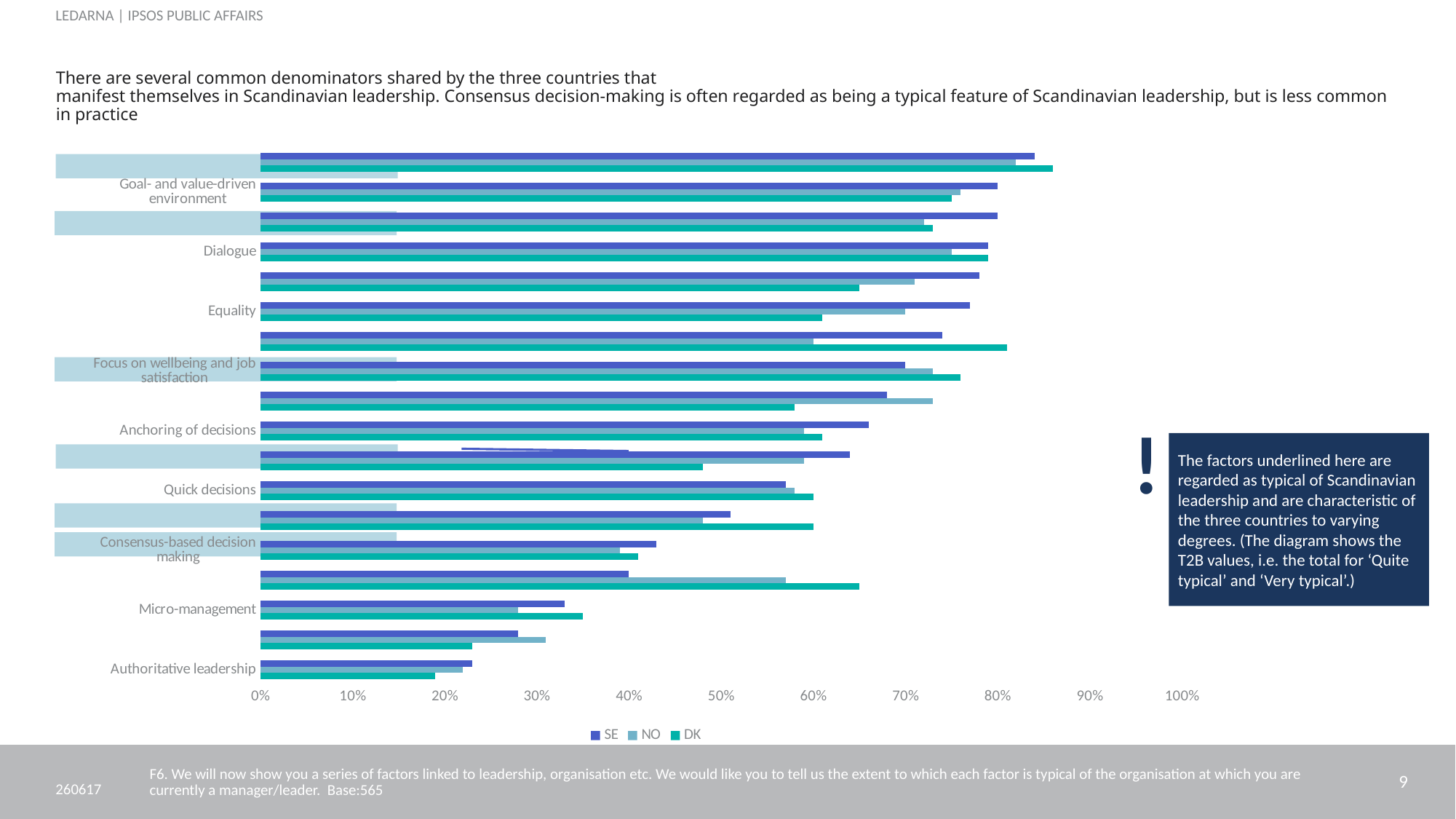
Is the SE value for Consensus-based decision making greater or less than 50%? less For Goal- and value-driven environment, which series has the highest value? SE For Anchoring of decisions, which series has the highest value? SE Is the SE value for Goal- and value-driven environment greater or less than 70%? greater For Micro-management, which series has the lowest value? NO What kind of chart is shown on the slide? Bar chart Is the DK value for Equality greater or less than 70%? less How many series does the legend list? 3 Which is larger: the DK value for Micro-management or the DK value for Authoritative leadership? Micro-management Which series are listed in the chart legend? SE, NO, DK For Equality, which series has the lowest value? DK